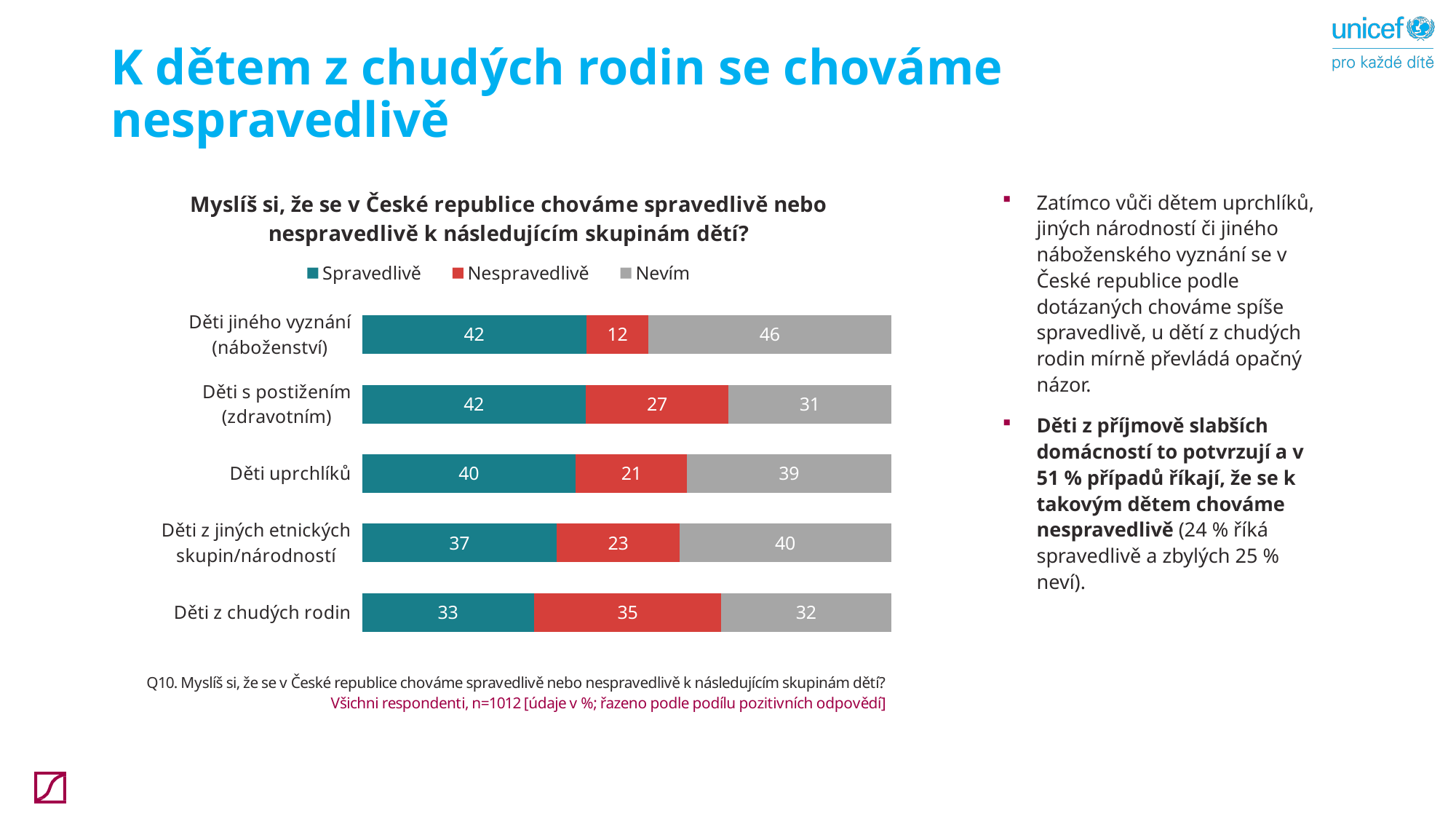
What is the difference between the 'Nespravedlivě' values for 'Děti s postižením (zdravotním)' and 'Děti jiného vyznání (náboženství)'? 15 What is the 'Nespravedlivě' value for 'Děti z chudých rodin'? 35 How many categories are shown in the chart? 5 What is the 'Spravedlivě' value for 'Děti uprchlíků'? 40 Which category has the highest 'Nespravedlivě' value? Děti z chudých rodin Which category has the lowest 'Nespravedlivě' value? Děti jiného vyznání (náboženství) Which series is shown in red in the chart? Nespravedlivě What kind of chart is shown on the slide? Stacked bar chart Which is larger for 'Děti z jiných etnických skupin/národností': the 'Spravedlivě' value or the 'Nevím' value? Nevím How many series does the legend list? 3 What is the 'Nevím' value for 'Děti jiného vyznání (náboženství)'? 46 What is the total of the stacked bar for 'Děti uprchlíků'? 100